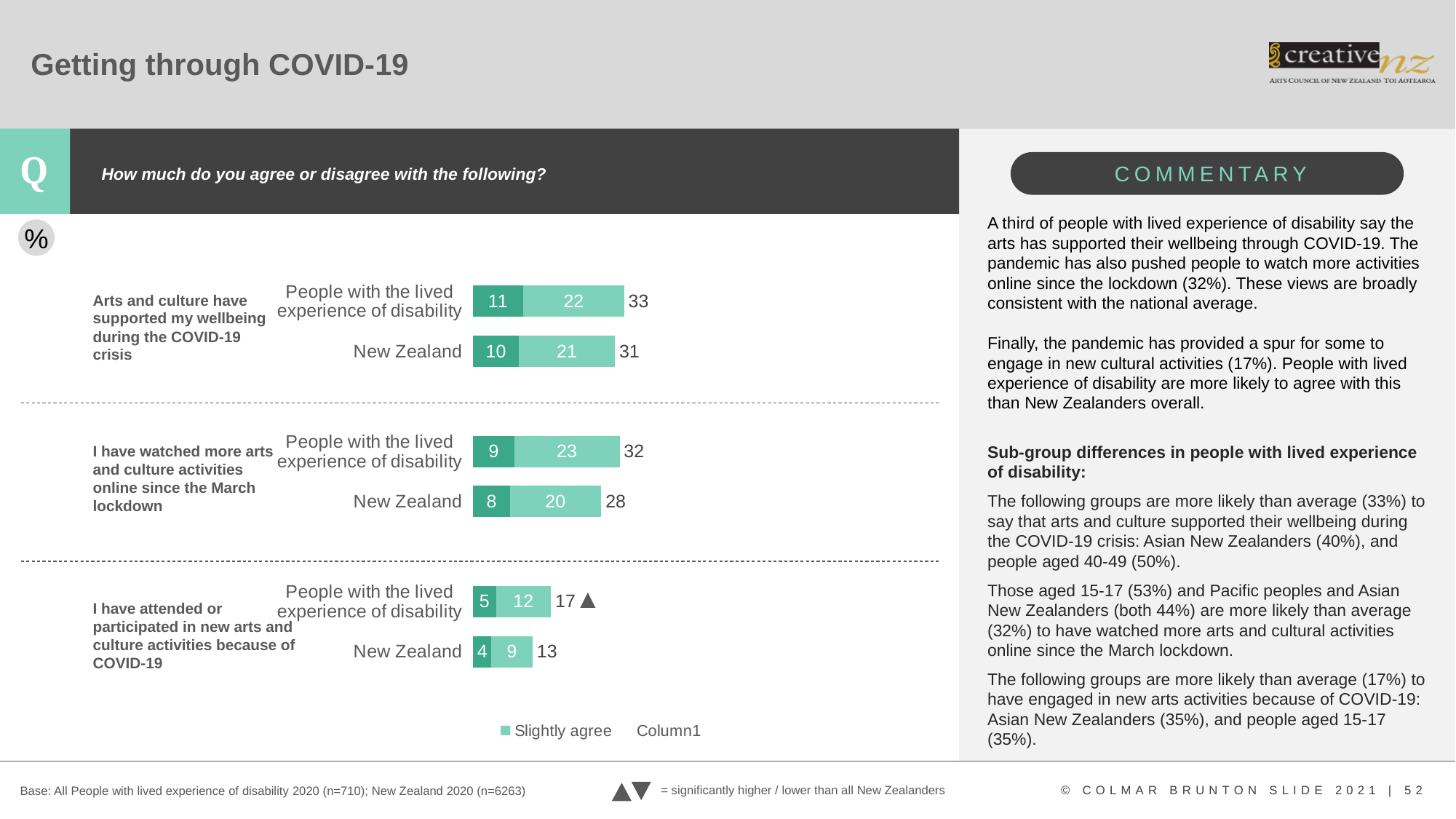
What kind of chart is shown on the slide? Bar chart What is the 'Slightly agree' value for New Zealand for 'Arts and culture have supported my wellbeing during the COVID-19 crisis'? 21 For 'I have watched more arts and culture activities online since the March lockdown', which group has the larger total: People with the lived experience of disability or New Zealand? People with the lived experience of disability Which bar has the lowest total on the chart? New Zealand for 'I have attended or participated in new arts and culture activities because of COVID-19' (13) What is the difference between the totals for People with the lived experience of disability and New Zealand for 'I have attended or participated in new arts and culture activities because of COVID-19'? 4 What is the total value for New Zealand for 'I have watched more arts and culture activities online since the March lockdown'? 28 What is the difference between the totals for People with the lived experience of disability and New Zealand for 'Arts and culture have supported my wellbeing during the COVID-19 crisis'? 2 How many entries does the chart legend list? 2 Which statement has the highest total for People with the lived experience of disability? Arts and culture have supported my wellbeing during the COVID-19 crisis How many statements are shown on the chart? 3 What is the total value for People with the lived experience of disability for 'Arts and culture have supported my wellbeing during the COVID-19 crisis'? 33 What is the value of the dark teal segment for New Zealand for 'I have attended or participated in new arts and culture activities because of COVID-19'? 4